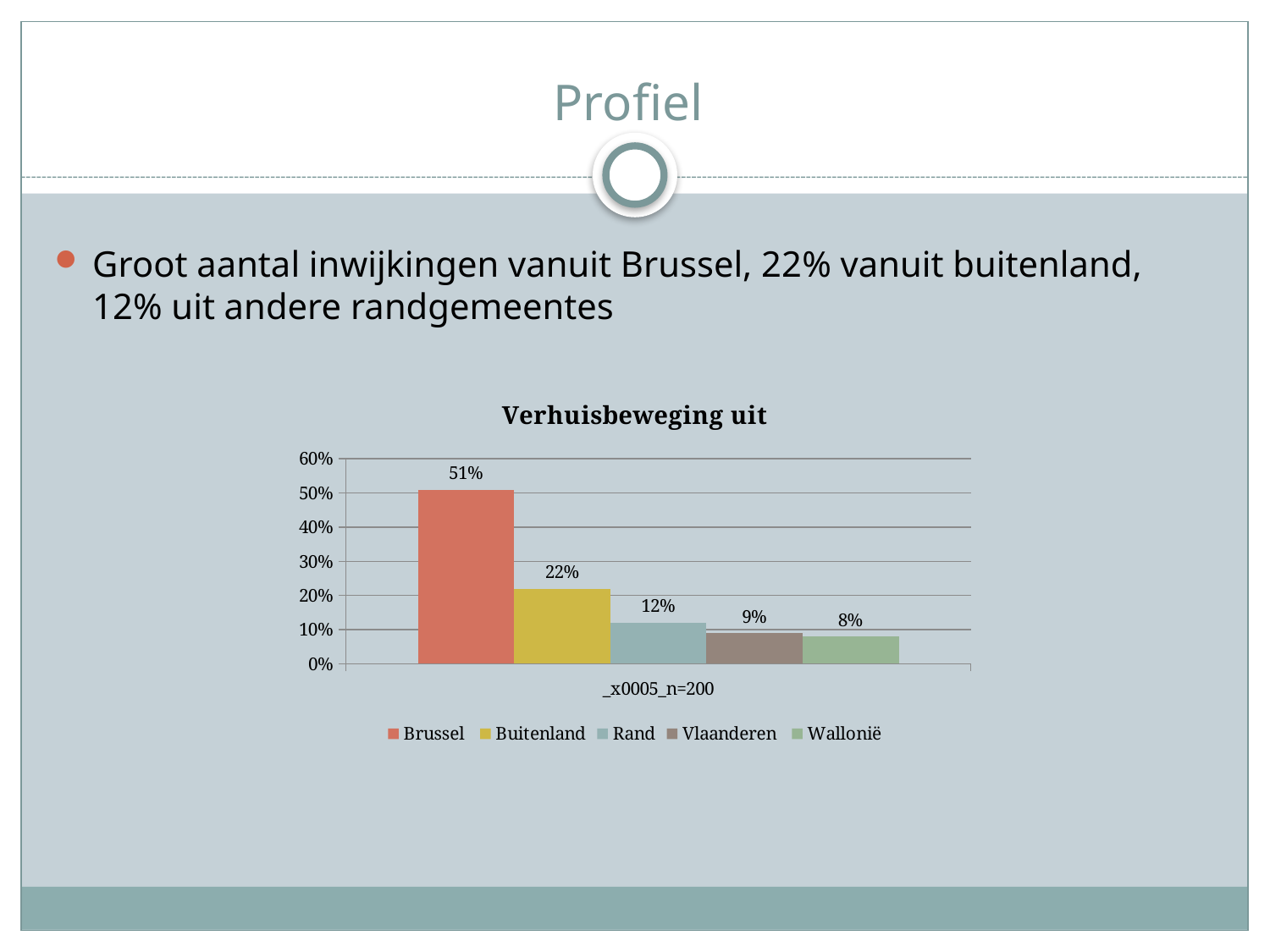
What is the value for Rand in the chart? 12% How many series does the legend list? 5 What is the difference between the values for Brussel and Buitenland? 29% What is the value for Brussel in the chart? 51% Which series has the lowest value in the chart? Wallonië What is the value for Wallonië in the chart? 8% Which is larger, the value for Rand or the value for Vlaanderen? Rand Which series has the highest value in the chart? Brussel What kind of chart is shown on the slide? Bar chart What is the title of the chart? Verhuisbeweging uit What is the value for Vlaanderen in the chart? 9% What is the value for Buitenland in the chart? 22%